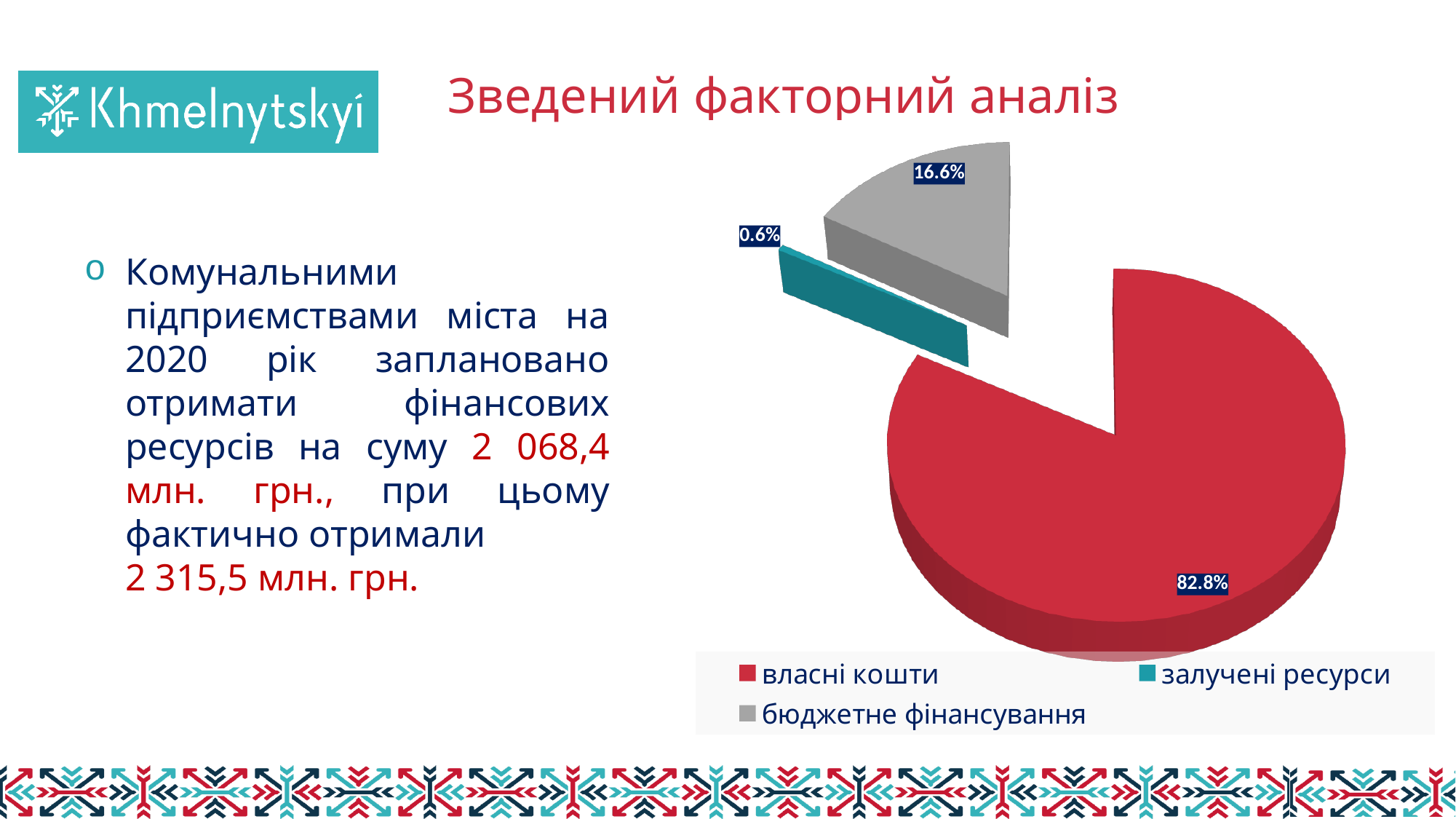
Which category has the smallest slice of the pie? залучені ресурси What is the difference in percentage points between власні кошти and бюджетне фінансування? 66.2 Which is larger, the slice for бюджетне фінансування or the slice for залучені ресурси? бюджетне фінансування Which category has the largest slice of the pie? власні кошти What share of the pie does залучені ресурси represent? 0.6% What is the difference in percentage points between бюджетне фінансування and залучені ресурси? 16 How many slices does the pie chart have? 3 What kind of chart is shown on the slide? pie chart What share of the pie does власні кошти represent? 82.8% What colour is the slice for залучені ресурси? teal What share of the pie does бюджетне фінансування represent? 16.6% How many entries does the legend list? 3